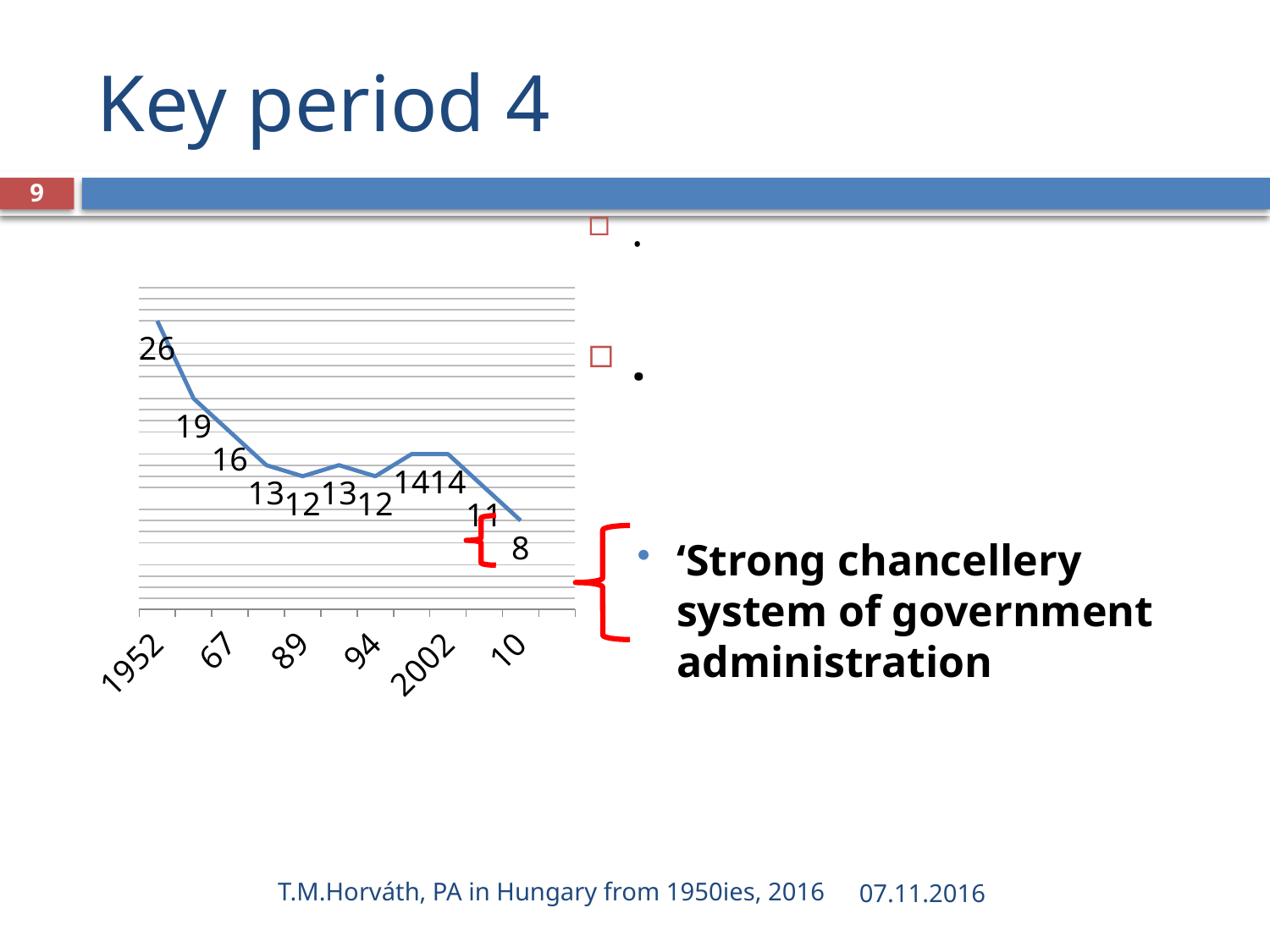
What is the value plotted for 1952? 26 What kind of chart is shown on the slide? line chart Which point has the lowest value on the chart? 10 Do the values generally rise or fall from left to right along the x axis? fall What is the difference between the value for 1952 and the value for 10? 18 Which is larger, the value for 1952 or the value for 10? 1952 Which point has the highest value on the chart? 1952 What is the highest value shown as a data label on the chart? 26 What colour is the plotted line? blue What is the value plotted for the last point, labelled 10? 8 What is the lowest value shown as a data label on the chart? 8 How many data points are plotted on the line? 11